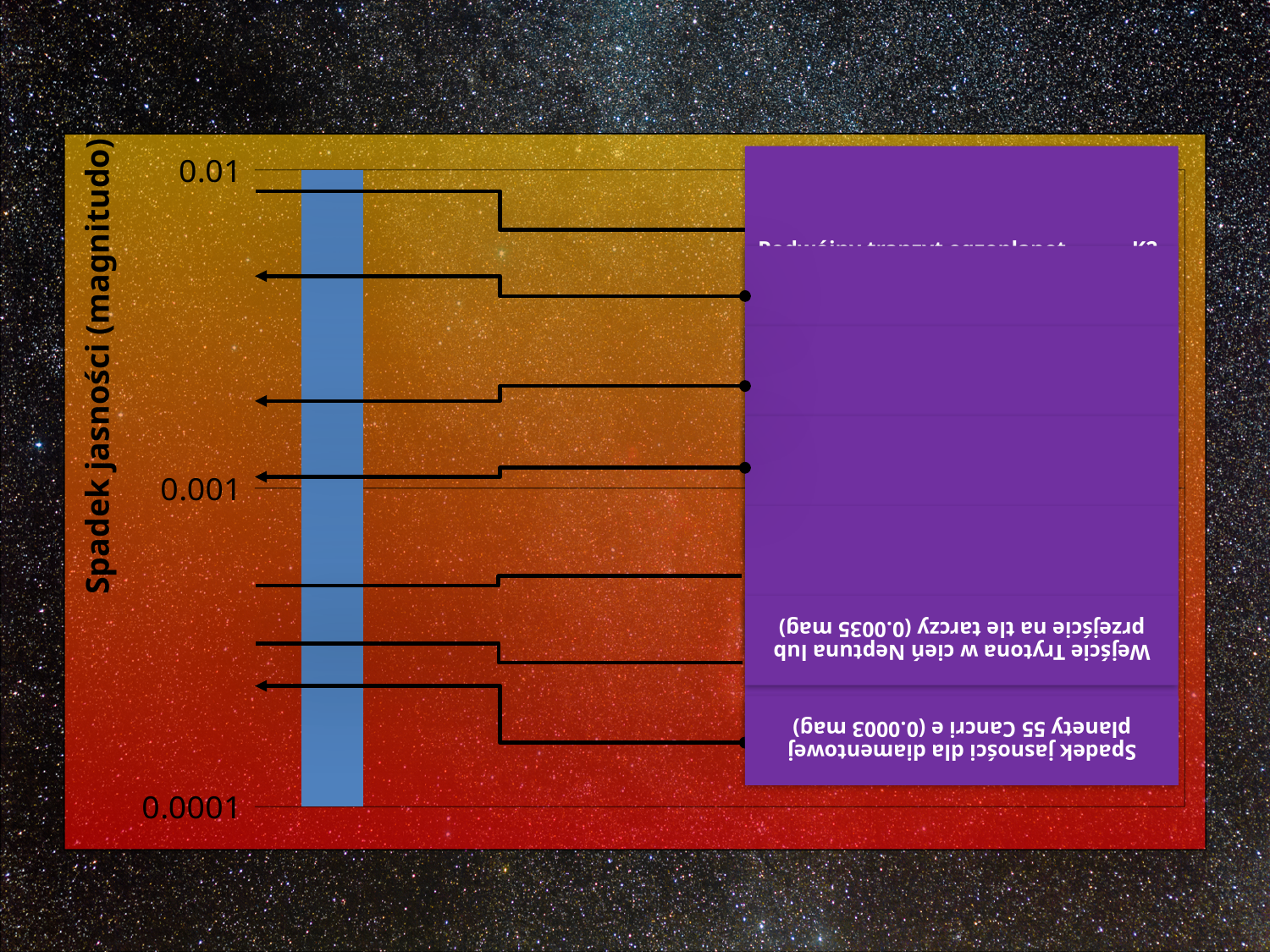
Which has the larger brightness drop according to the labels: the Triton event or the 55 Cancri e transit? Triton event What is the value of the bottom tick on the vertical axis? 0.0001 What is the label on the vertical axis of the chart? Spadek jasności (magnitudo) What brightness drop is given in the label for Triton entering Neptune's shadow or transiting its disk? 0.0035 mag What colour is the vertical bar drawn on the left side of the chart? Blue How many arrows point from the purple box toward the vertical axis? 7 What is the value of the middle tick on the vertical axis? 0.001 What brightness drop is given in the label for the diamond planet 55 Cancri e? 0.0003 mag What is the value of the topmost tick on the vertical axis? 0.01